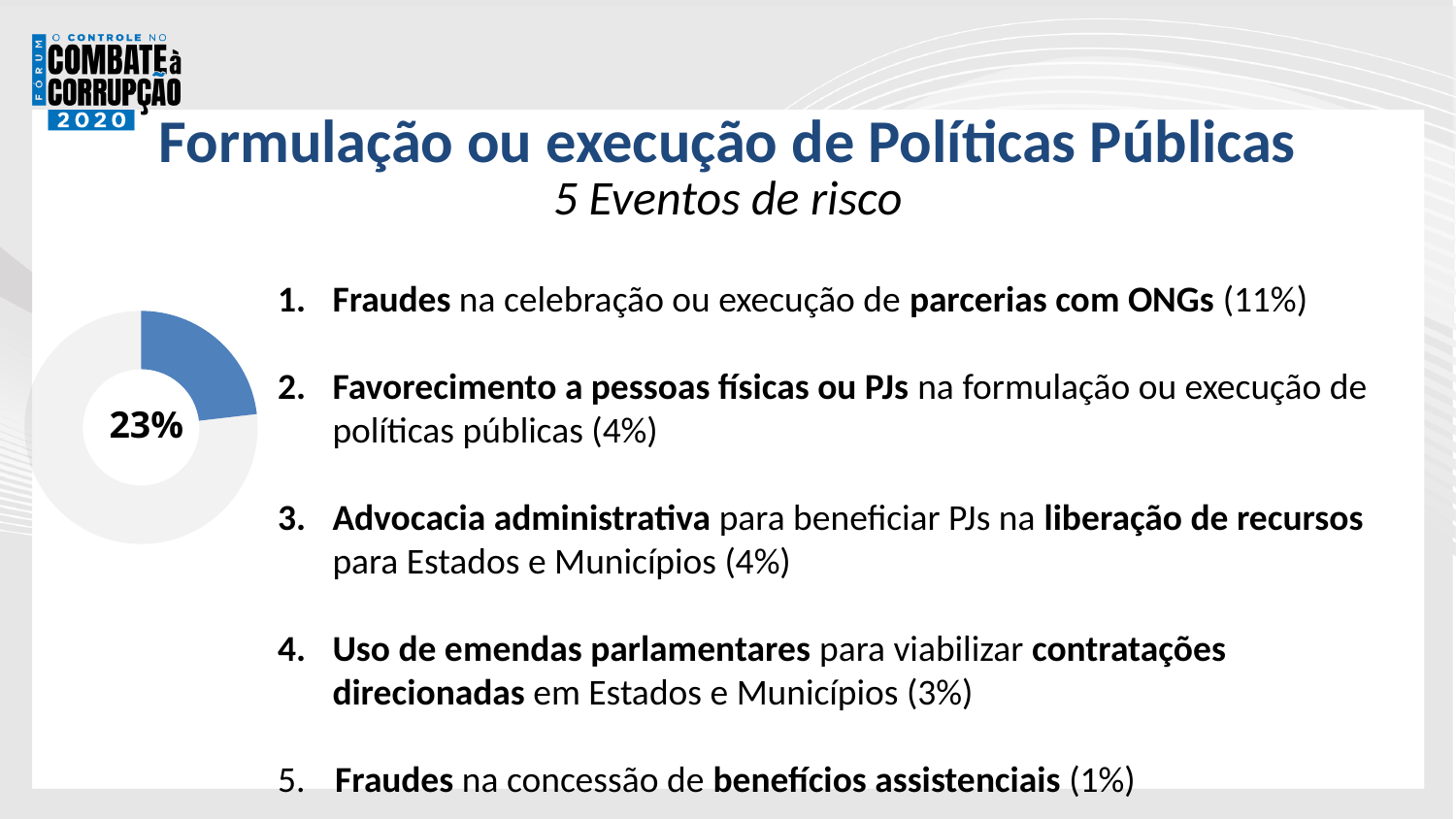
Does the doughnut chart display a legend? No Is the value of the blue slice in the doughnut chart greater or less than 50%? less What colour is the highlighted slice of the doughnut chart? blue What share of the doughnut chart does the grey portion represent? 77% What kind of chart is shown on the left of the slide? doughnut chart How many slices does the doughnut chart have? 2 What percentage is printed in the centre of the doughnut chart? 23% Is the value of the blue slice in the doughnut chart greater or less than 20%? greater Which slice of the doughnut chart is larger, the blue one or the grey one? the grey one